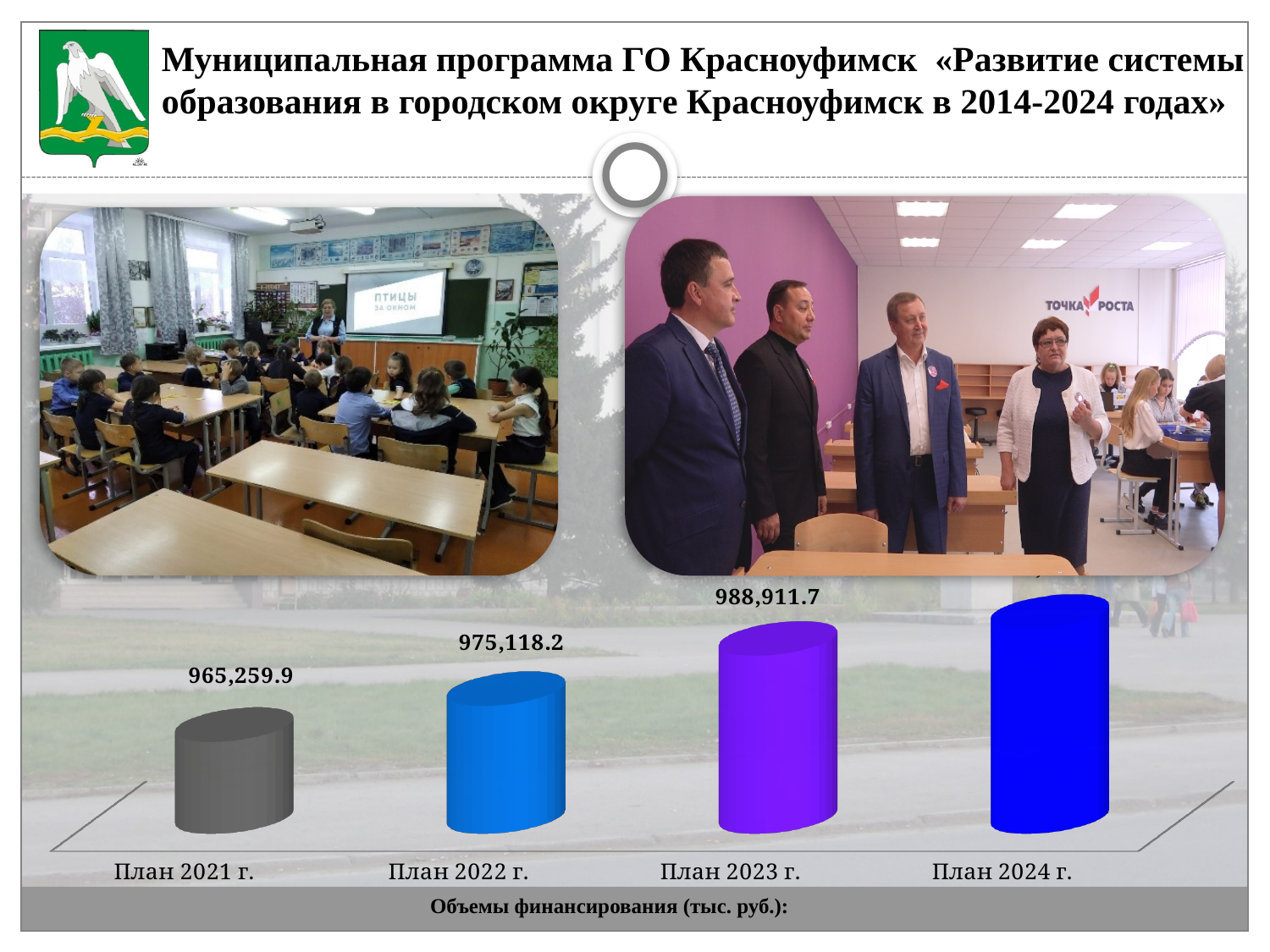
What is the value for План 2021 г.? 965,259.9 Do the values rise or fall from План 2021 г. to План 2024 г.? Rise What is the difference between the values for План 2023 г. and План 2022 г.? 13,793.5 Which is larger, the value for План 2023 г. or План 2021 г.? План 2023 г. How many categories are shown in the chart? 4 Which category has the lowest value? План 2021 г. In what units are the financing volumes given, according to the caption below the chart? тыс. руб. What kind of chart is shown on the slide? Bar chart What is the value for План 2022 г.? 975,118.2 What is the difference between the values for План 2022 г. and План 2021 г.? 9,858.3 What is the value for План 2023 г.? 988,911.7 Which category has the highest bar? План 2024 г.